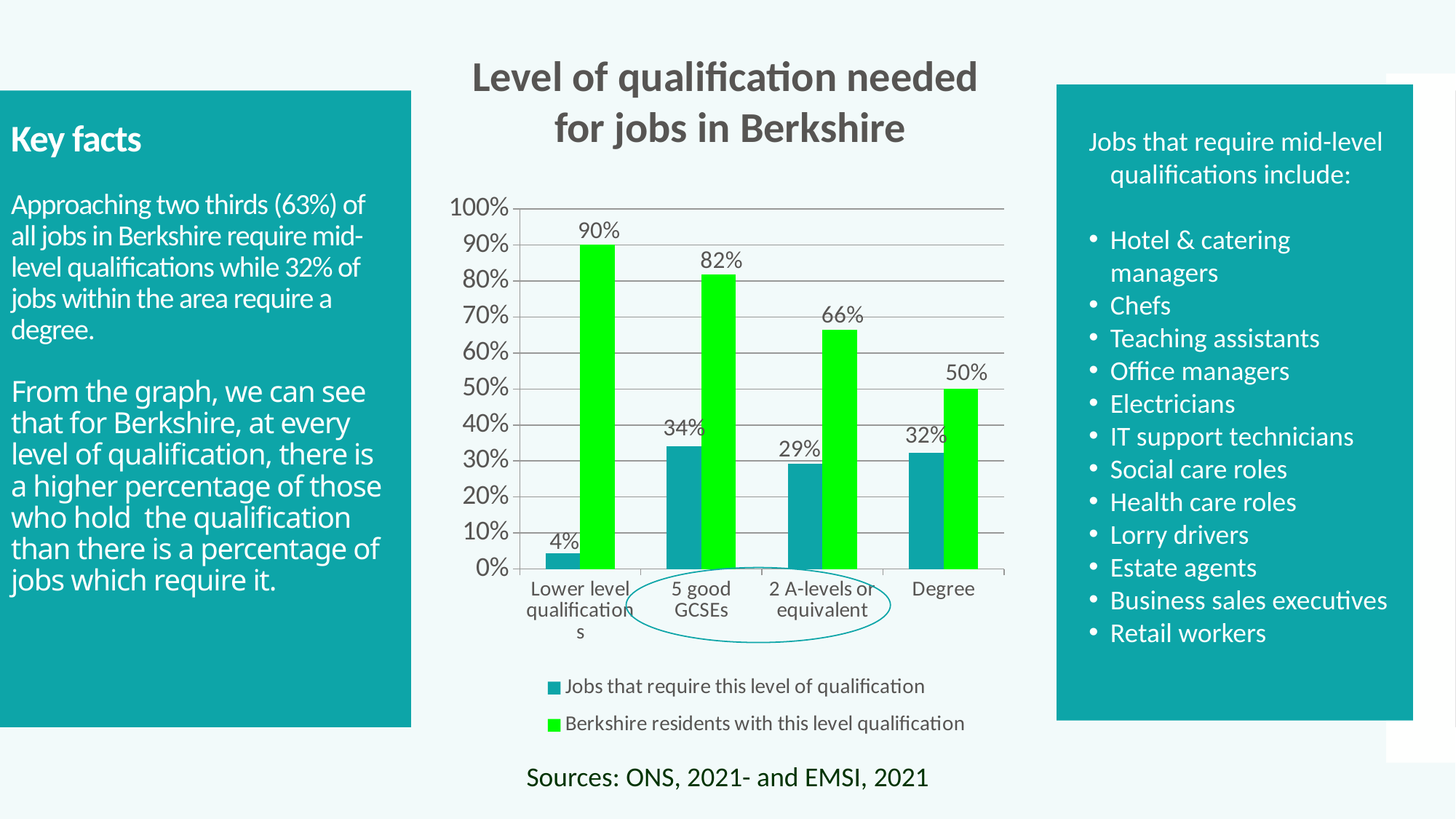
What type of chart is shown? Bar chart What percentage of jobs require 2 A-levels or equivalent? 29% How many series does the legend list? 2 What percentage of jobs require 5 good GCSEs? 34% What is the difference between the percentage of Berkshire residents with 5 good GCSEs and the percentage of jobs requiring 5 good GCSEs? 48% What percentage of Berkshire residents have lower level qualifications? 90% Which qualification level has the lowest percentage of jobs requiring it? Lower level qualifications Which is larger: the percentage of jobs requiring a degree or the percentage of jobs requiring 5 good GCSEs? Jobs requiring 5 good GCSEs What percentage of Berkshire residents hold a degree? 50% How many qualification levels are shown on the x axis? 4 What colour are the bars for Berkshire residents with this level qualification? Green Which qualification level has the highest percentage of Berkshire residents holding it? Lower level qualifications